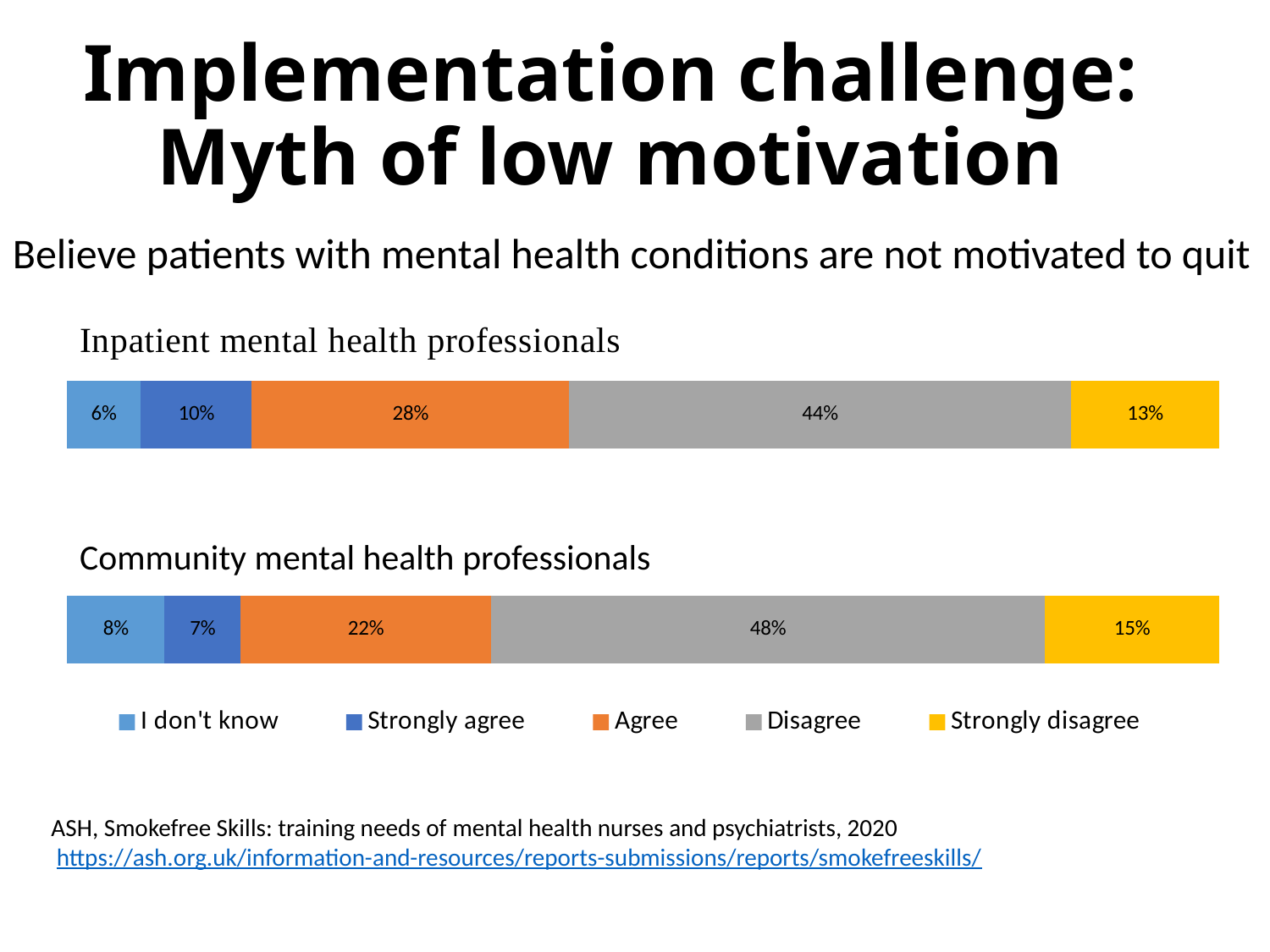
In the Inpatient mental health professionals chart, what percentage is shown for Disagree? 44% In the Community mental health professionals chart, which response has the largest share? Disagree How many response categories does the legend list? 5 In the Community mental health professionals chart, what percentage is shown for Agree? 22% In the Community mental health professionals chart, what percentage is shown for I don't know? 8% Which colour represents Strongly disagree in the legend? Yellow In the Inpatient mental health professionals chart, which response has the smallest share? I don't know What is the difference between the Disagree percentages in the Community mental health professionals chart and the Inpatient mental health professionals chart? 4% What type of chart is used on this slide? Stacked bar chart Which is larger: the Agree percentage for Inpatient mental health professionals or for Community mental health professionals? Inpatient mental health professionals In the Inpatient mental health professionals chart, what percentage is shown for Strongly agree? 10% In the Inpatient mental health professionals chart, what is the combined percentage of Strongly agree and Agree? 38%